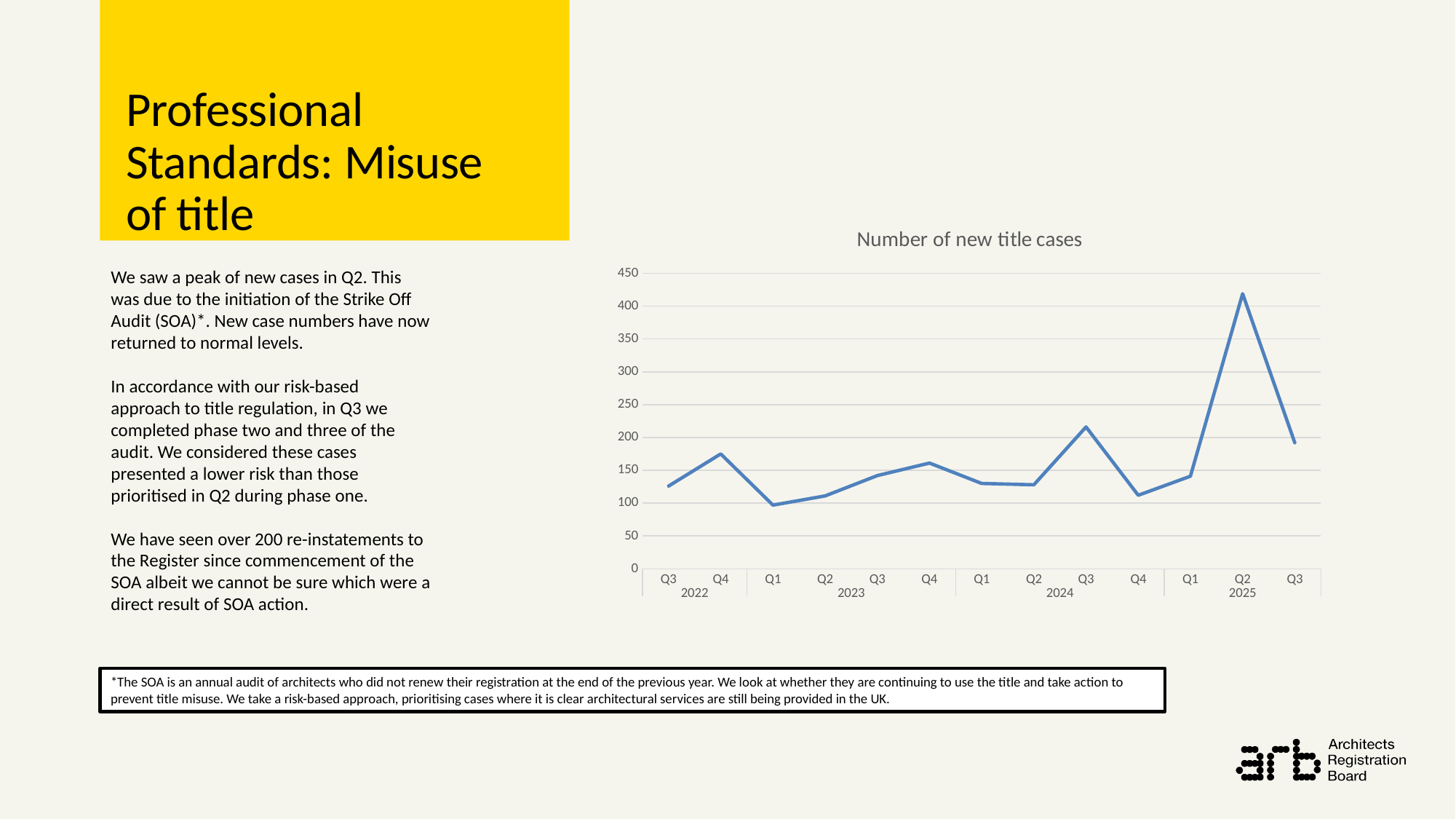
How many quarterly data points are plotted on the chart? 13 In which quarter is the number of new title cases lowest? Q1 2023 Which quarter has more new title cases, Q3 2024 or Q4 2024? Q3 2024 Which quarter has more new title cases, Q4 2022 or Q1 2023? Q4 2022 Is the value for Q2 2025 greater or less than 400? greater Is the value for Q4 2022 greater or less than 200? less What is the title of the chart? Number of new title cases What kind of chart is shown on the slide? Line chart In which quarter is the number of new title cases highest? Q2 2025 Does the number of new title cases rise or fall from Q2 2025 to Q3 2025? Fall Is the value for Q3 2024 greater or less than 200? greater